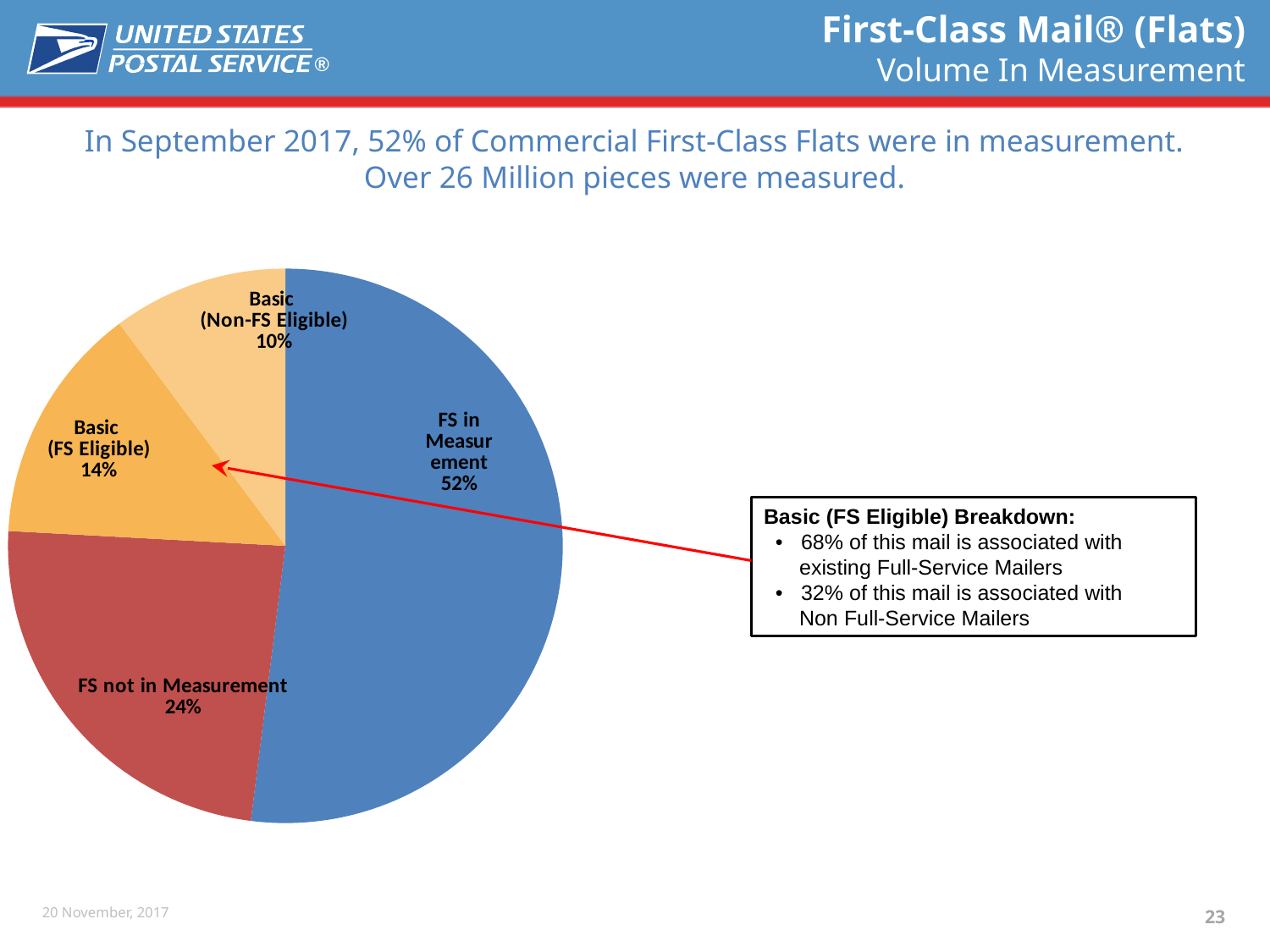
Which is larger, Basic (FS Eligible) or Basic (Non-FS Eligible)? Basic (FS Eligible) What is the combined share of the two Basic slices? 24% What share of the pie is Basic (FS Eligible)? 14% What kind of chart is shown on the slide? Pie chart What share of the pie is Basic (Non-FS Eligible)? 10% What colour is the FS not in Measurement slice? Red What is the difference in percentage points between FS in Measurement and FS not in Measurement? 28 Which slice of the pie is the smallest? Basic (Non-FS Eligible) Which slice of the pie is the largest? FS in Measurement How many slices does the pie chart have? 4 What share of the pie is FS not in Measurement? 24%